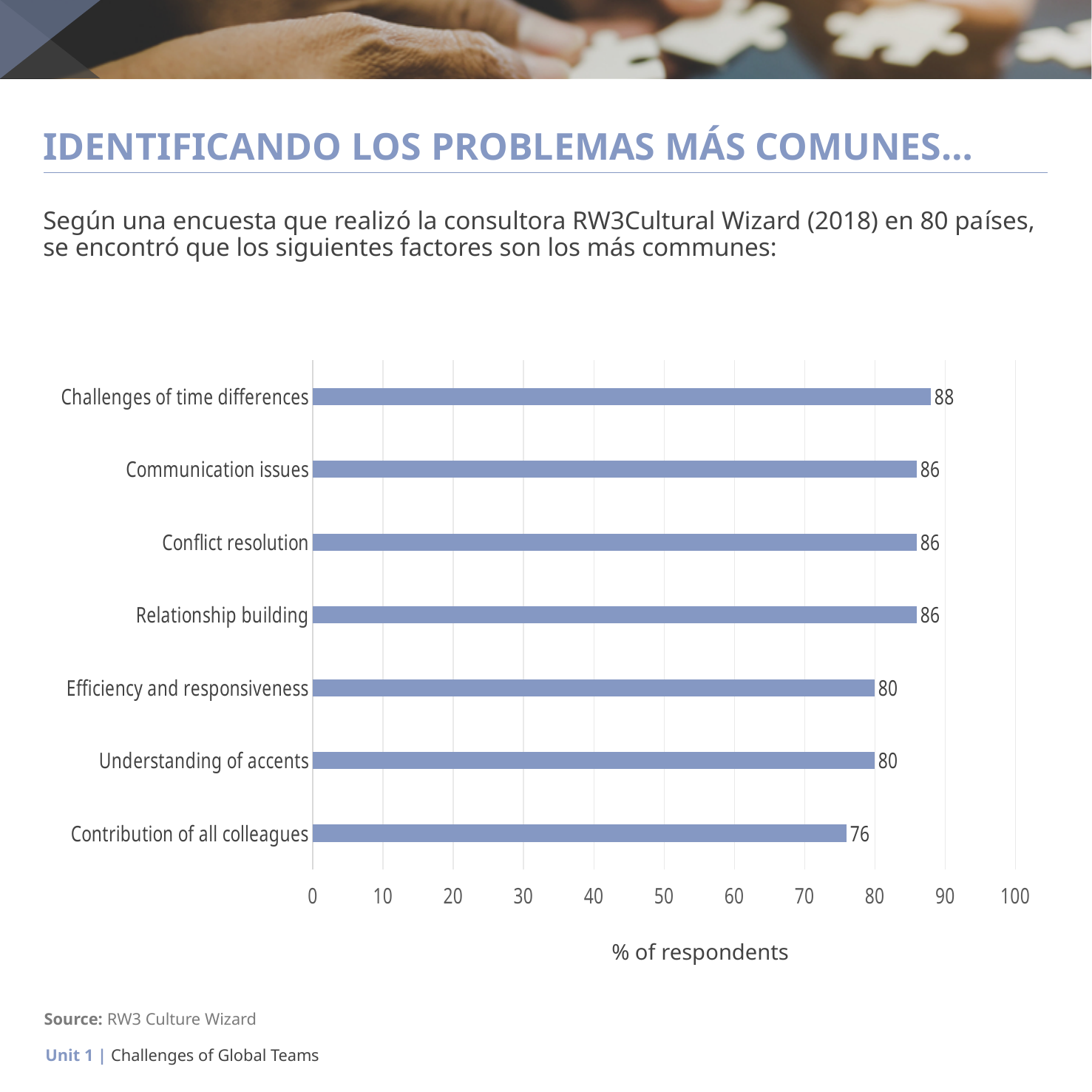
What is the value for Efficiency and responsiveness? 80 What is the label of the horizontal axis? % of respondents What is the difference between the values for Challenges of time differences and Contribution of all colleagues? 12 What is the value for Challenges of time differences? 88 What is the value for Conflict resolution? 86 How many categories are shown in the chart? 7 Which is larger, the value for Relationship building or the value for Understanding of accents? Relationship building What is the value for Contribution of all colleagues? 76 What kind of chart is shown on the slide? Bar chart Which category has the lowest value? Contribution of all colleagues What is the difference between the values for Communication issues and Understanding of accents? 6 Which category has the highest value? Challenges of time differences